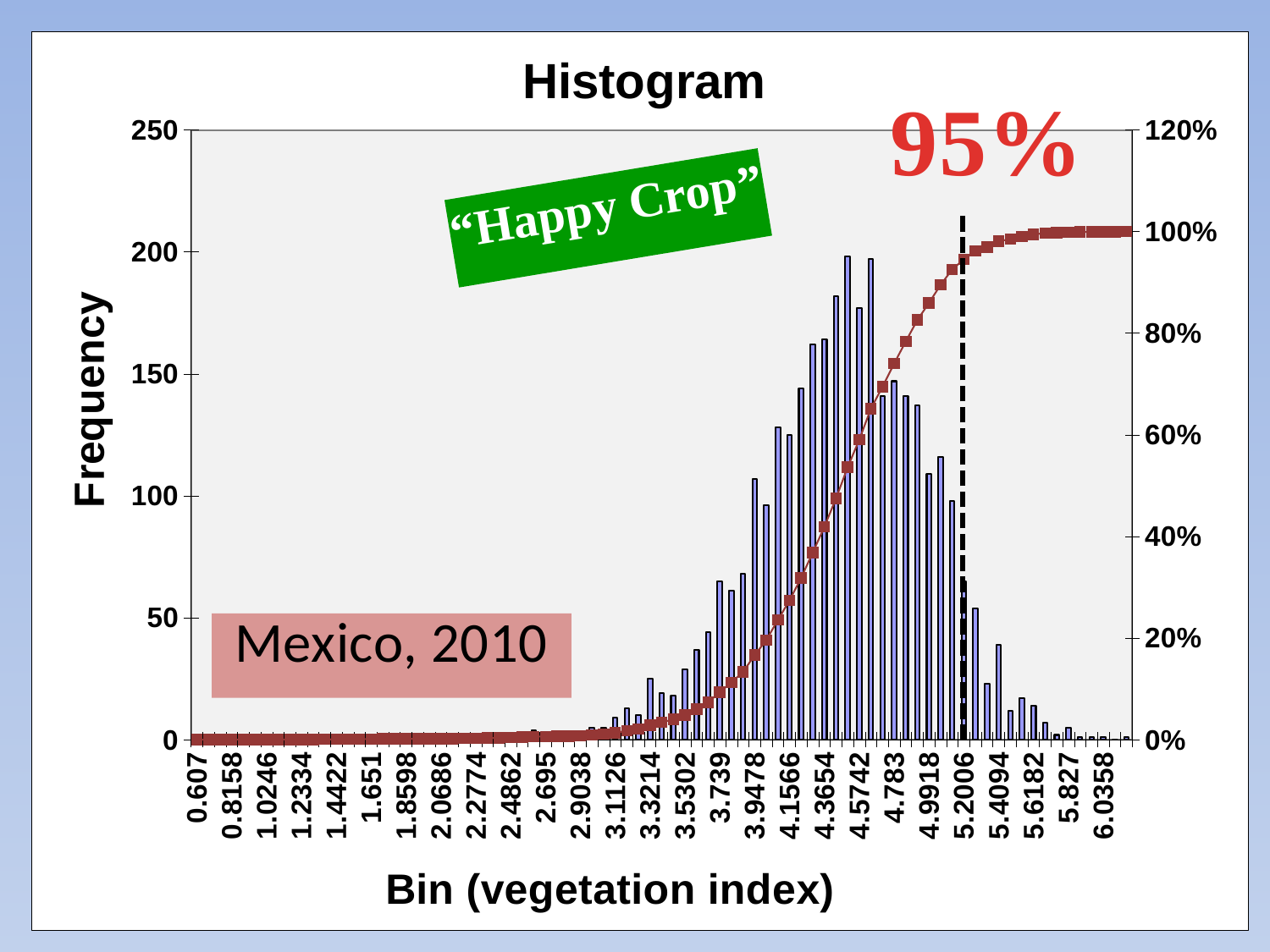
Is the tallest bar in the histogram greater or less than 250? less Is the frequency for the bin 6.0358 greater or less than 50? less Is the tallest bar in the histogram greater or less than 150? greater What kind of chart is shown on the slide? bar chart (histogram) with a cumulative line What is the label of the x axis? Bin (vegetation index) What is the title of the chart? Histogram Does the cumulative percentage line rise or fall as the bin value increases along the x axis? rise Do the frequency bars rise or fall from bin 4.783 to bin 6.0358? fall Do the frequency bars rise or fall from bin 3.1126 to bin 4.3654? rise